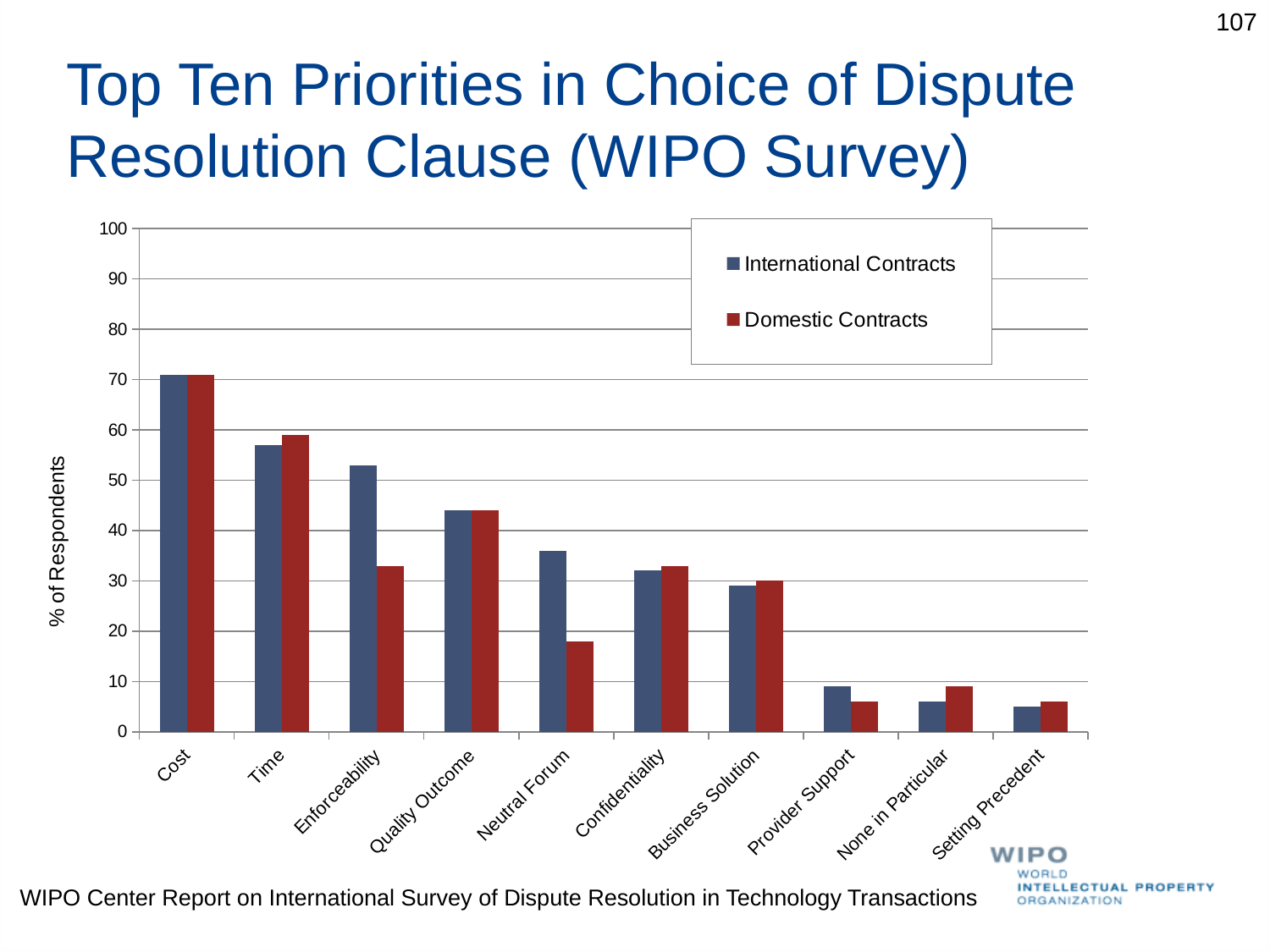
For Neutral Forum, which series has the larger value, International Contracts or Domestic Contracts? International Contracts How many series does the legend list? 2 How many categories are shown on the x axis? 10 Which category has the lowest value for International Contracts? Setting Precedent Which category has the highest value for International Contracts? Cost Is the International Contracts value for Cost greater or less than 60? greater Which category has the highest value for Domestic Contracts? Cost For Enforceability, which series has the larger value, International Contracts or Domestic Contracts? International Contracts What kind of chart is shown on the slide? bar chart What is the label on the vertical axis? % of Respondents Is the Domestic Contracts value for Enforceability greater or less than 40? less Do the values generally rise or fall moving from left to right along the x axis? fall